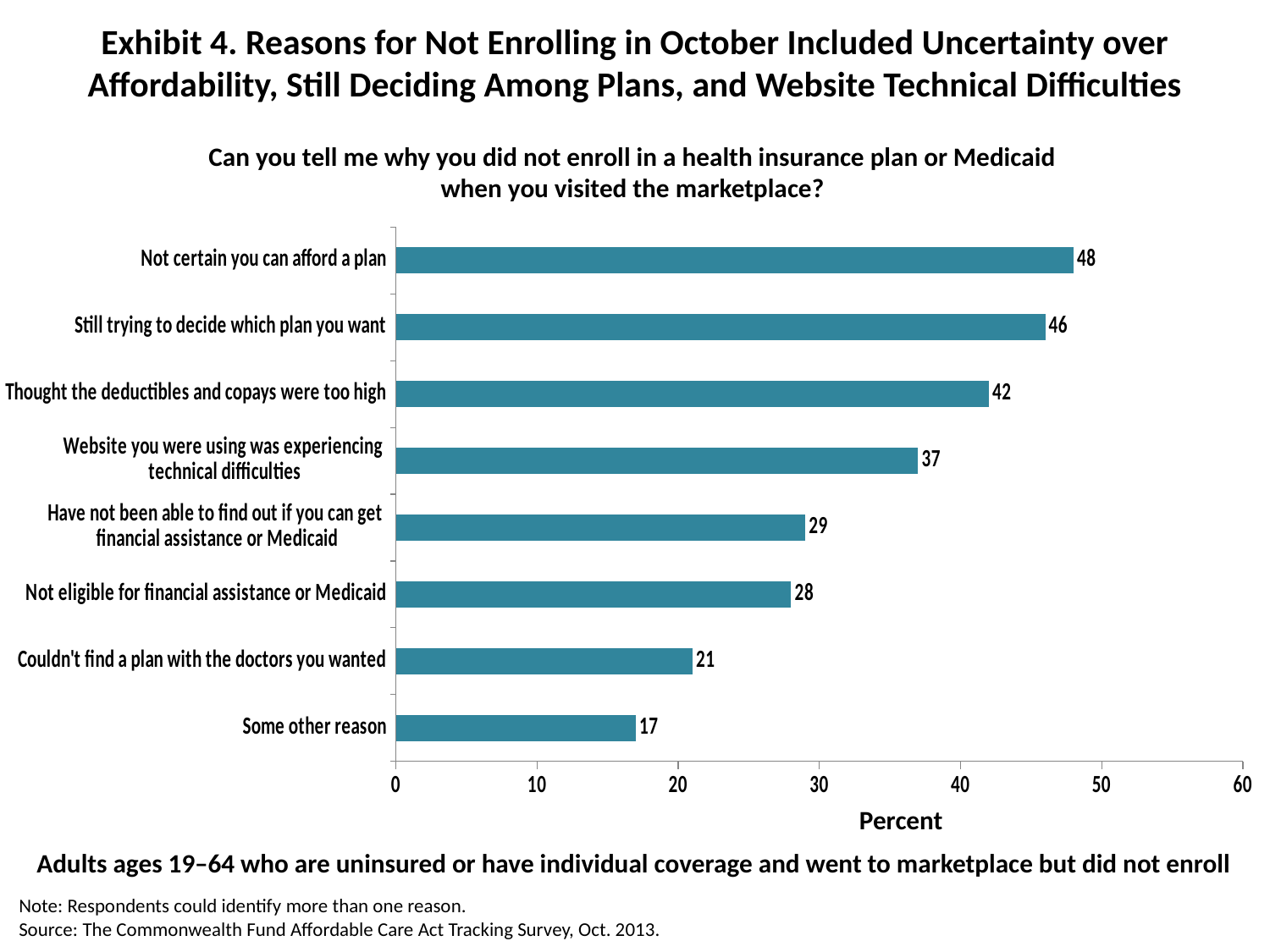
What kind of chart is shown on the slide? Bar chart Is the value for 'Not eligible for financial assistance or Medicaid' greater or less than 30? less What is the label of the horizontal axis? Percent What is the difference between 'Not certain you can afford a plan' and 'Still trying to decide which plan you want'? 2 What is the value for 'Couldn't find a plan with the doctors you wanted'? 21 What is the value for 'Website you were using was experiencing technical difficulties'? 37 How many reasons are shown in the chart? 8 What percent of respondents said they were not certain they could afford a plan? 48 Which reason has the highest value? Not certain you can afford a plan What is the difference between 'Thought the deductibles and copays were too high' and 'Some other reason'? 25 Which reason has the lowest value? Some other reason Which is larger: 'Have not been able to find out if you can get financial assistance or Medicaid' or 'Couldn't find a plan with the doctors you wanted'? Have not been able to find out if you can get financial assistance or Medicaid